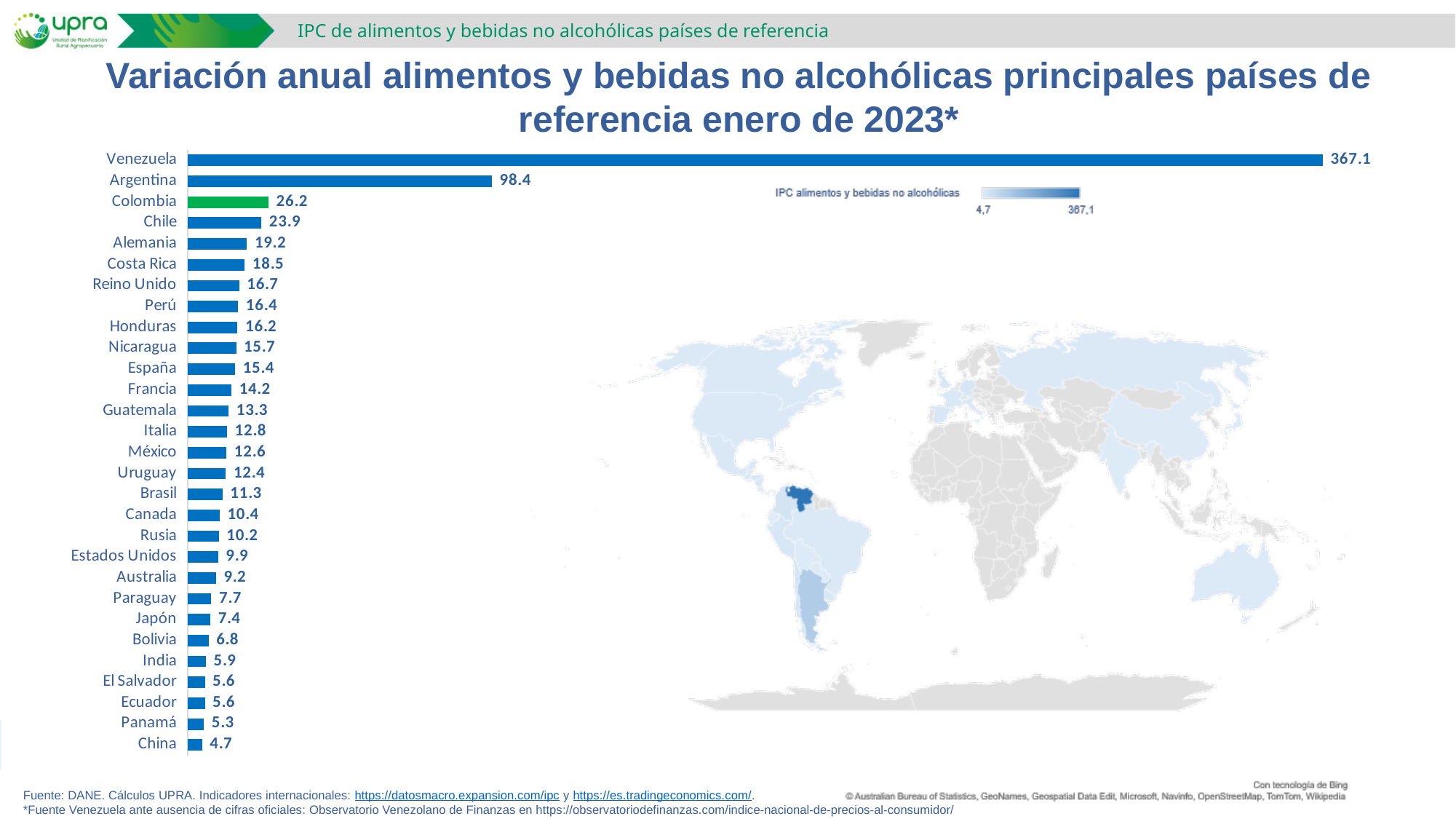
In the bar chart, what is the value for Colombia? 26.2 In the bar chart, what is the value for Japón? 7.4 In the bar chart, which country has the lowest value? China How many countries are shown in the bar chart? 29 In the bar chart, which has a larger value, Alemania or Costa Rica? Alemania In the bar chart, what is the difference between the values for Venezuela and Argentina? 268.7 What kind of chart is the chart on the left of the slide? Bar chart In the bar chart, what is the difference between the values for Colombia and Chile? 2.3 In the bar chart, which has a larger value, Brasil or Canada? Brasil In the bar chart, what is the value for Argentina? 98.4 In the bar chart, which country's bar is coloured green instead of blue? Colombia In the bar chart, which country has the highest value? Venezuela